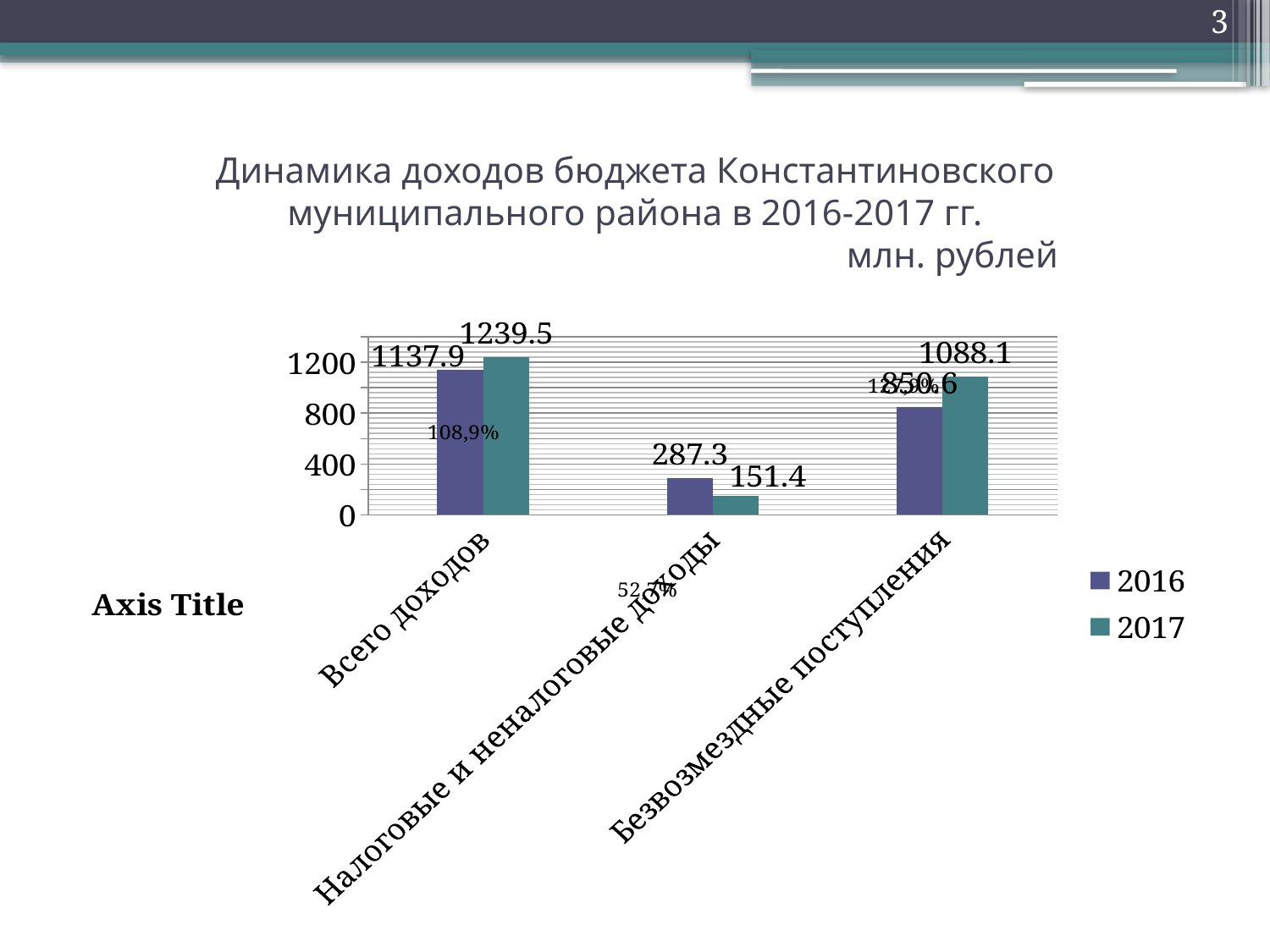
What is the value for 2017 in the category "Всего доходов"? 1239.5 By how much did "Всего доходов" increase from 2016 to 2017? 101.6 For "Безвозмездные поступления", which year has the larger value, 2016 or 2017? 2017 What is the difference between the 2016 and 2017 values for "Налоговые и неналоговые доходы"? 135.9 How many series does the legend list? 2 What is the value for 2017 in the category "Безвозмездные поступления"? 1088.1 What is the value for 2017 in the category "Налоговые и неналоговые доходы"? 151.4 How many categories are shown on the x axis? 3 What is the value for 2016 in the category "Всего доходов"? 1137.9 Which category has the lowest value for 2016? Налоговые и неналоговые доходы Which category has the highest value for 2017? Всего доходов What is the value for 2016 in the category "Налоговые и неналоговые доходы"? 287.3